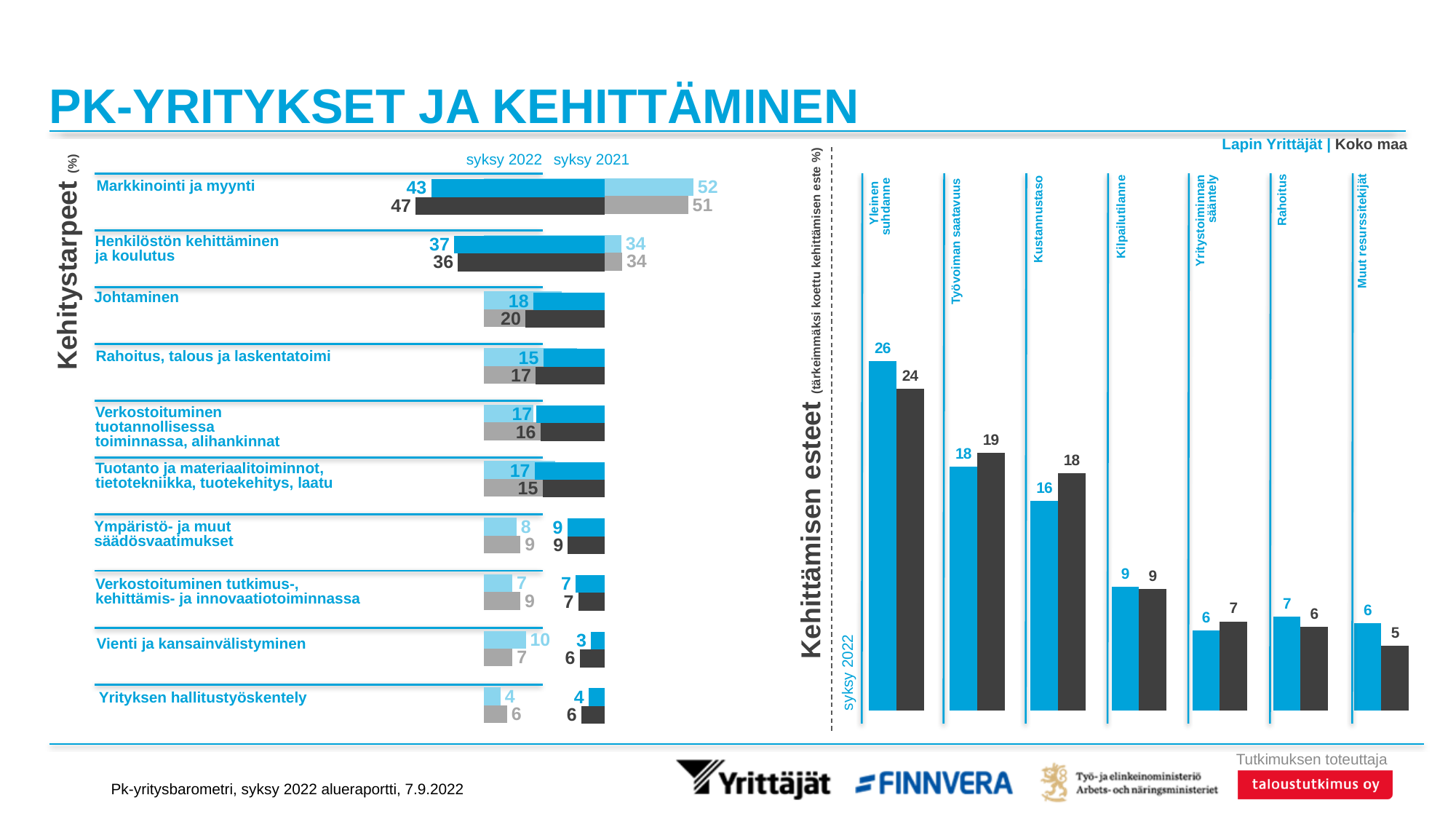
In the Kehittämisen esteet chart on the right, which category has the highest value for Lapin Yrittäjät? Yleinen suhdanne In the Kehittämisen esteet chart on the right, what is the Koko maa value for Kustannustaso? 18 What type of chart is the Kehittämisen esteet chart on the right? bar chart In the Kehitystarpeet chart on the left, what is the syksy 2022 Koko maa value for Vienti ja kansainvälistyminen? 6 In the Kehittämisen esteet chart on the right, how many categories are shown? 7 In the Kehittämisen esteet chart on the right, what is the value for Yleinen suhdanne for Lapin Yrittäjät? 26 In the Kehittämisen esteet chart on the right, which category has the lowest Koko maa value? Muut resurssitekijät In the Kehitystarpeet chart on the left, what is the syksy 2022 value for Markkinointi ja myynti for Lapin Yrittäjät? 43 In the Kehittämisen esteet chart on the right, what is the difference between the Lapin Yrittäjät and Koko maa values for Yleinen suhdanne? 2 In the Kehittämisen esteet chart on the right, is the Lapin Yrittäjät value for Työvoiman saatavuus larger or smaller than the Koko maa value? smaller In the Kehitystarpeet chart on the left, what is the syksy 2021 Koko maa value for Markkinointi ja myynti? 51